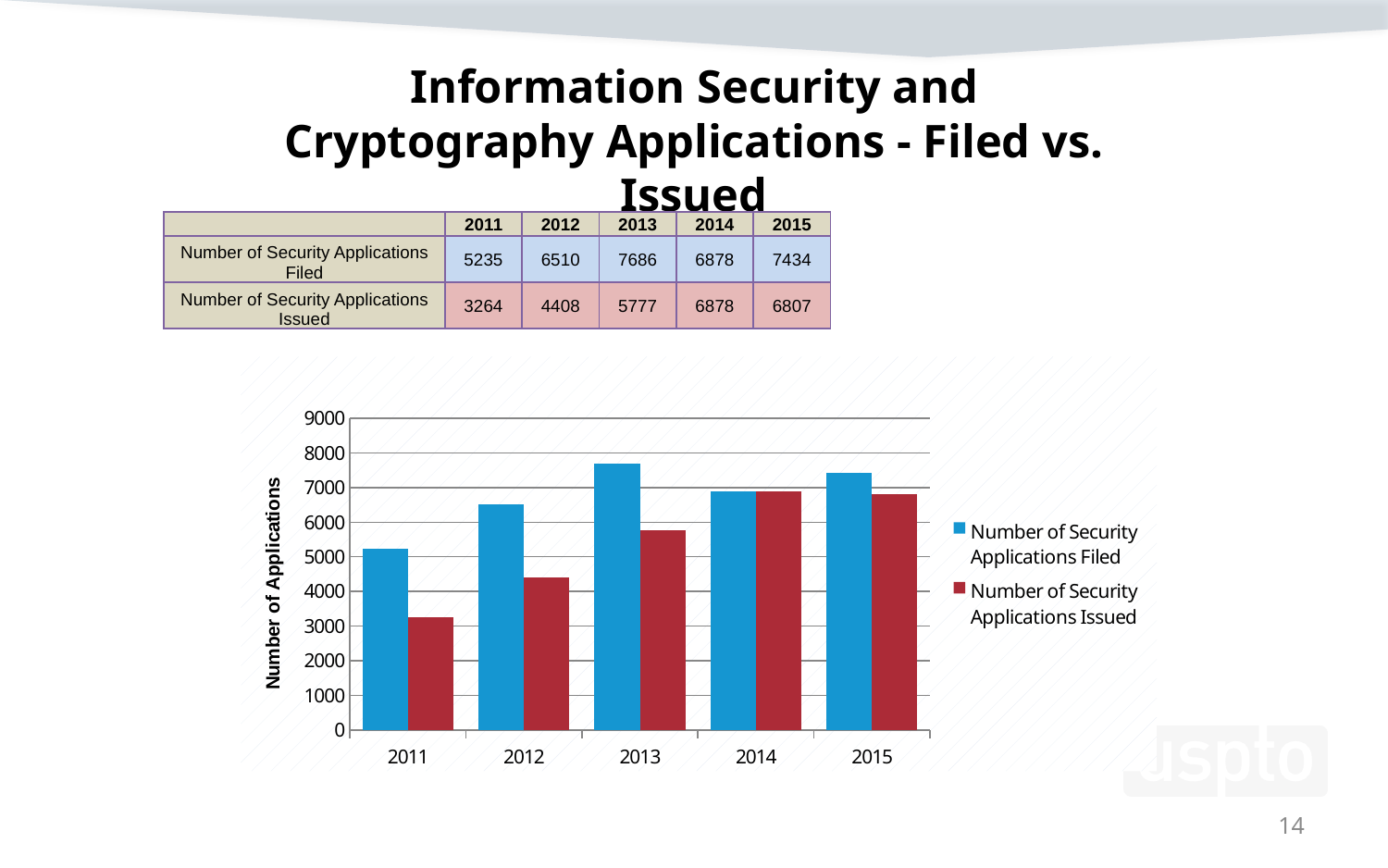
What kind of chart is shown on the slide? bar chart In which year is the Number of Security Applications Filed highest? 2013 In which year is the Number of Security Applications Issued lowest? 2011 What is the label on the vertical axis of the chart? Number of Applications What is the Number of Security Applications Issued in 2011? 3264 How many years are shown on the x axis of the chart? 5 How many series does the chart legend list? 2 Is the Number of Security Applications Issued in 2013 greater or less than 5000? greater What is the difference between the Number of Security Applications Filed and Issued in 2012? 2102 Does the Number of Security Applications Issued rise or fall from 2011 to 2014? rise Which is larger in 2015, the Number of Security Applications Filed or the Number of Security Applications Issued? Number of Security Applications Filed What is the Number of Security Applications Filed in 2013? 7686